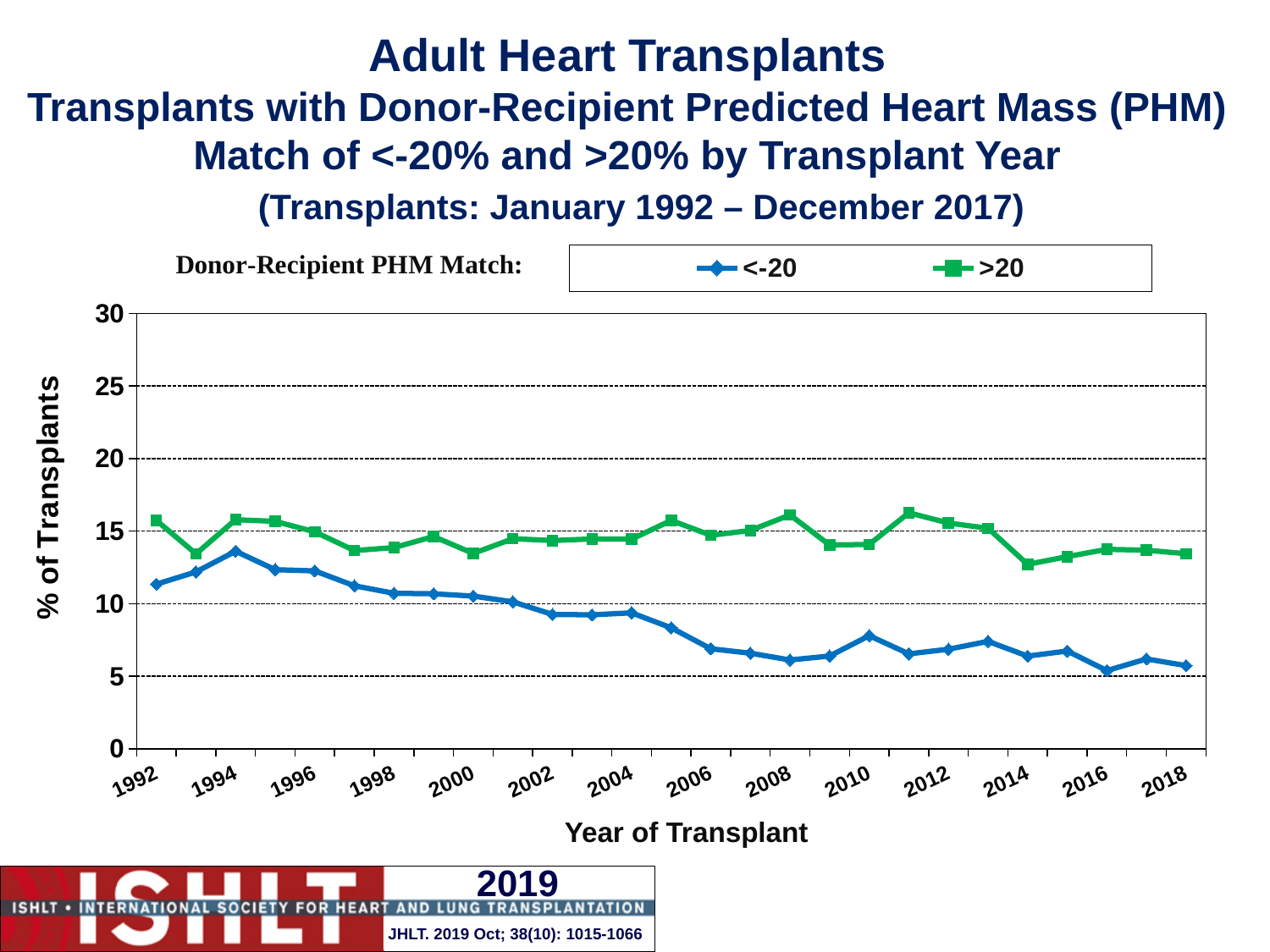
How many series does the legend list? 2 Is the value for the >20 series in 2014 greater or less than 15? less Is the value for the >20 series in 1992 greater or less than 15? greater In 2000, which series has the higher value, <-20 or >20? >20 What are the two series named in the legend? <-20 and >20 Is the value for the <-20 series in 1994 greater or less than 10? greater What kind of chart is shown on the slide? Line chart Does the <-20 series generally rise or fall from 1992 to 2017? Fall What is the title of the y axis? % of Transplants In which year does the <-20 series reach its highest value? 1994